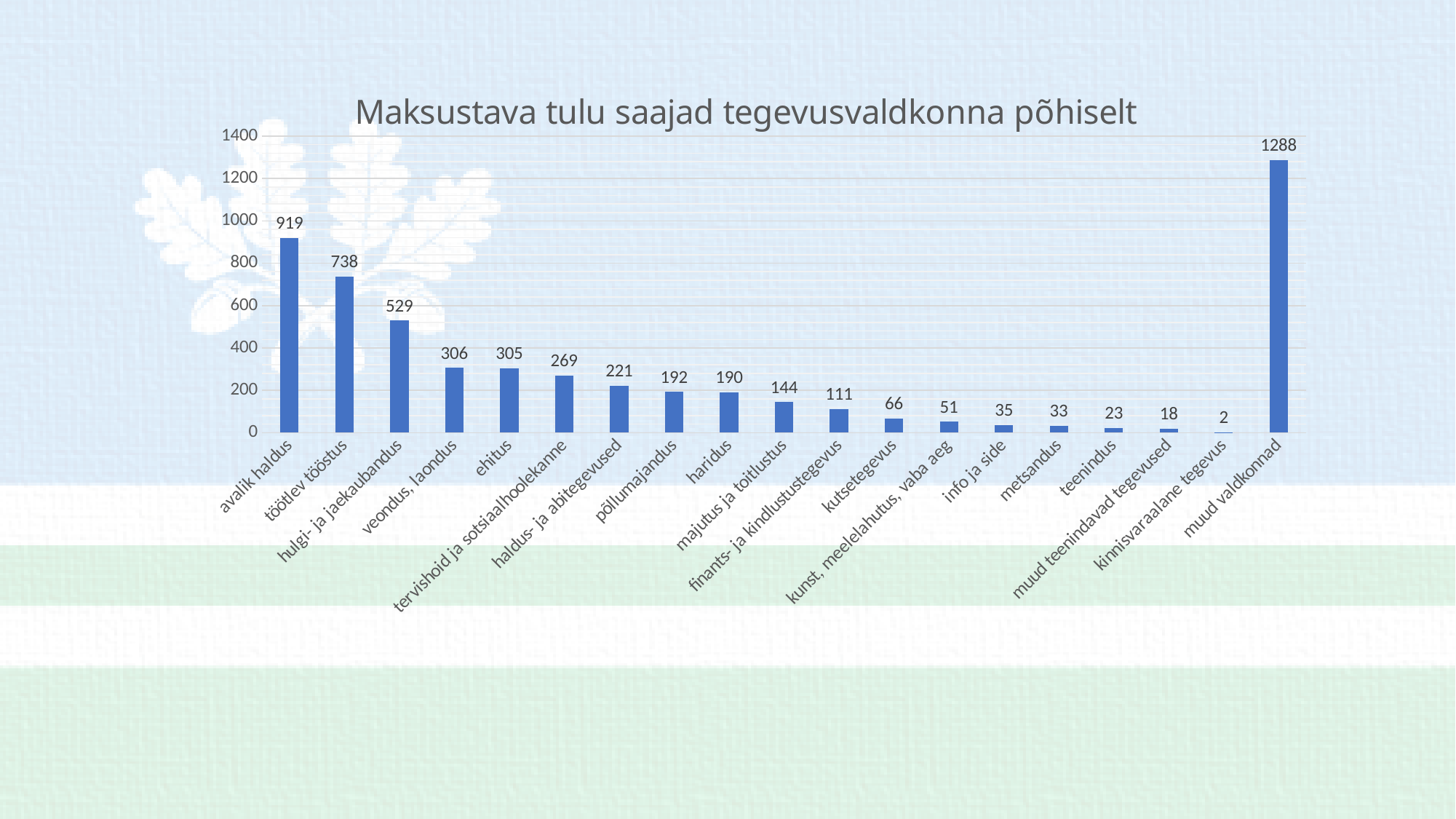
Which category has the lowest value? kinnisvaraalane tegevus Which category has the highest value? muud valdkonnad What is the difference between the values for muud valdkonnad and kinnisvaraalane tegevus? 1286 What is the value for hulgi- ja jaekaubandus? 529 What is the difference between the values for töötlev tööstus and avalik haldus? 181 What kind of chart is shown on the slide? bar chart What is the value for avalik haldus? 919 What is the value for metsandus? 33 What is the title of the chart? Maksustava tulu saajad tegevusvaldkonna põhiselt What is the value for haridus? 190 How many categories are shown on the x axis? 19 Which is larger, the value for põllumajandus or the value for majutus ja toitlustus? põllumajandus